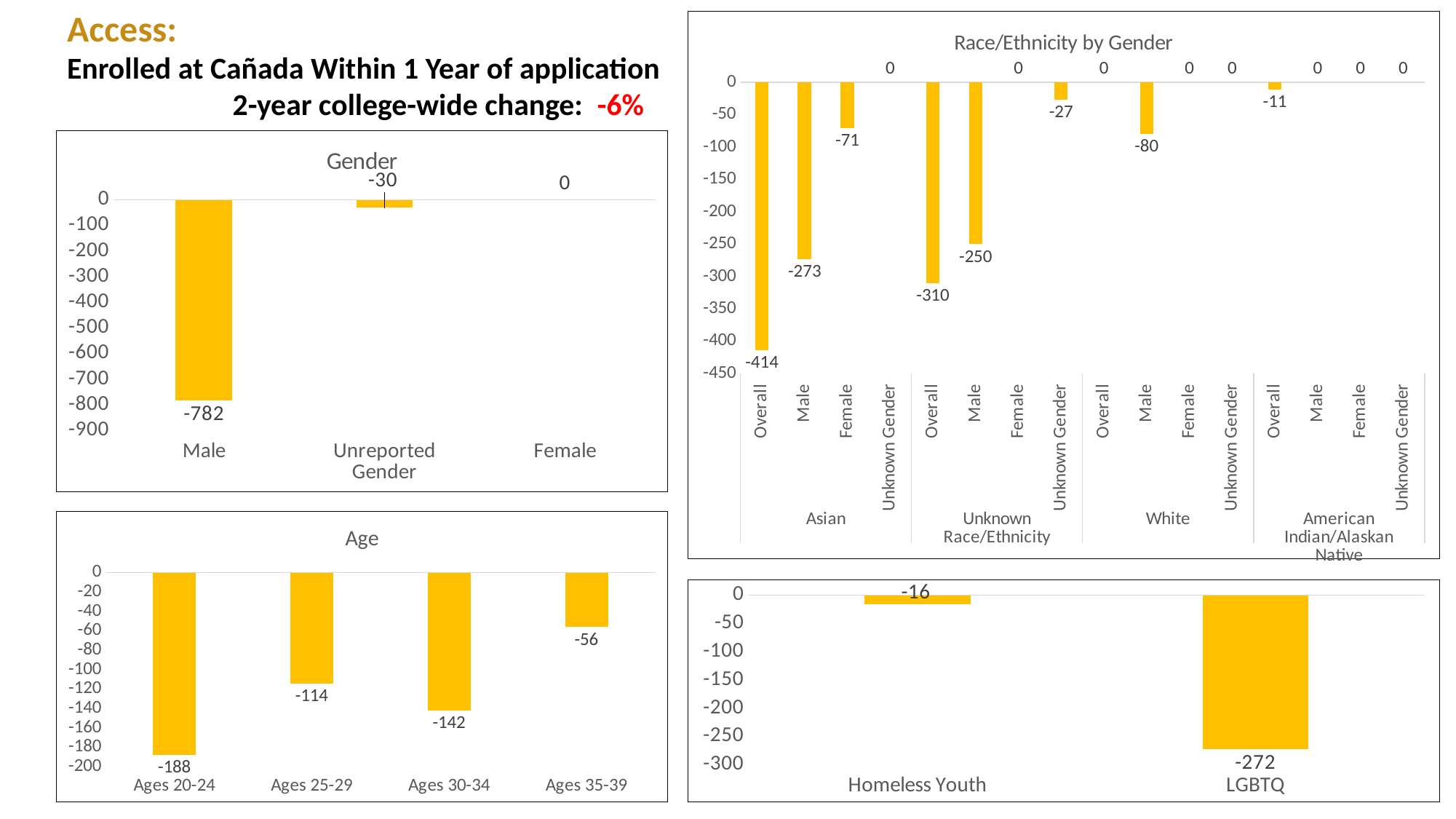
In the Age chart, how many age categories are shown? 4 In the Age chart, which category has the highest value? Ages 35-39 In the Gender chart, which category has the lowest value? Male In the Race/Ethnicity by Gender chart, what is the Overall value for Asian? -414 In the Race/Ethnicity by Gender chart, which is lower, the Male value for Asian or the Male value for Unknown Race/Ethnicity? Asian In the Age chart, what is the difference between the values for Ages 20-24 and Ages 35-39? 132 In the Gender chart, what is the value for Unreported Gender? -30 In the Age chart, what is the value for Ages 30-34? -142 In the Race/Ethnicity by Gender chart, what is the Male value for White? -80 In the Gender chart, what is the value for Male? -782 In the bottom-right chart, what is the value for LGBTQ? -272 What kind of chart is the Age chart? bar chart